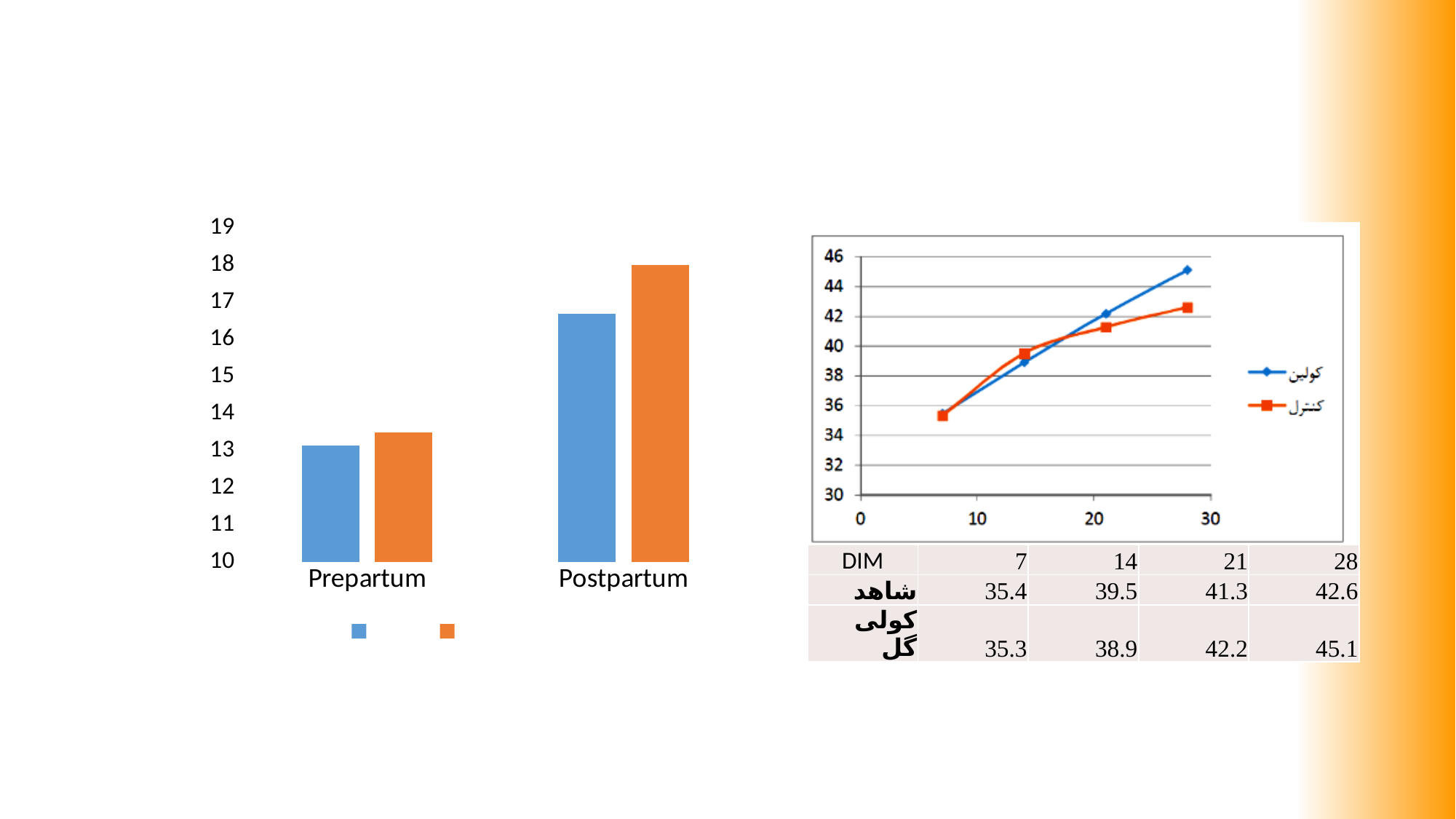
How many series does the legend of the right line chart list? 2 How many categories does the left bar chart show on its x axis? 2 In the left bar chart, is the orange bar for Postpartum greater or less than 17? greater According to the table under the right line chart, what is the value for شاهد at DIM 14? 39.5 According to the table under the right line chart, what is the value for کولی گل at DIM 28? 45.1 In the left bar chart, do the values rise or fall from Prepartum to Postpartum? rise In the right line chart, what is the difference between the two series at DIM 28 (45.1 and 42.6)? 2.5 What kind of chart is the chart on the left of the slide? bar chart What kind of chart is the chart on the right of the slide? line chart In the left bar chart, is the blue bar for Prepartum greater or less than 14? less In the right line chart, do the values of the blue series rise or fall as DIM increases? rise In the left bar chart, which category has the taller blue bar, Prepartum or Postpartum? Postpartum